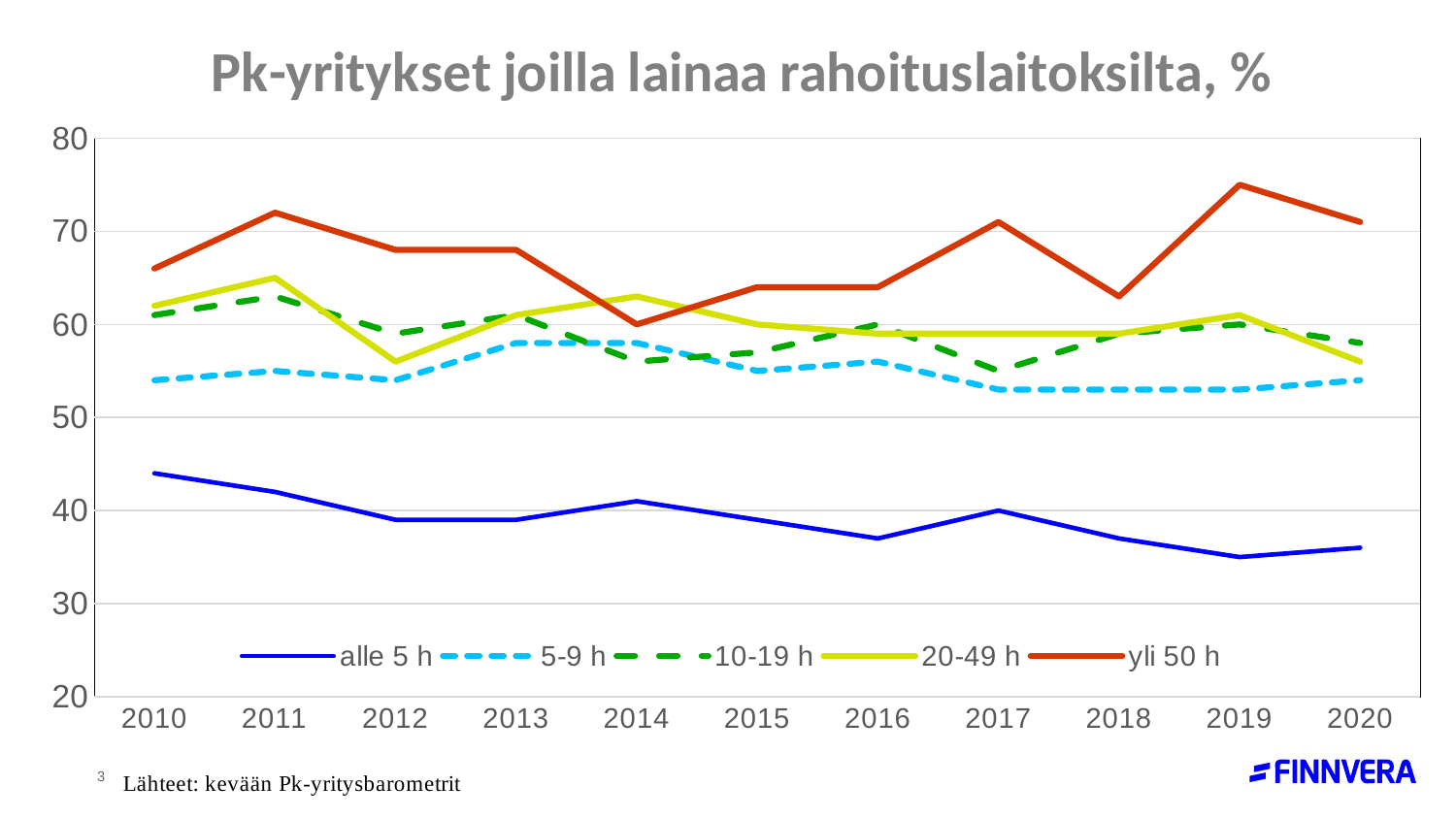
Is the value for alle 5 h in 2019 greater or less than 40? less What is the title of the chart? Pk-yritykset joilla lainaa rahoituslaitoksilta, % How many series does the legend list? 5 How many years are shown on the x axis? 11 Is the value for yli 50 h in 2019 greater or less than 70? greater Does the alle 5 h series overall rise or fall from 2010 to 2020? fall Is the value for alle 5 h in 2010 greater or less than 40? greater Which series has the lowest value in 2010? alle 5 h In 2020, which series is larger: yli 50 h or alle 5 h? yli 50 h Which series has the highest value in 2019? yli 50 h What kind of chart is shown on the slide? line chart